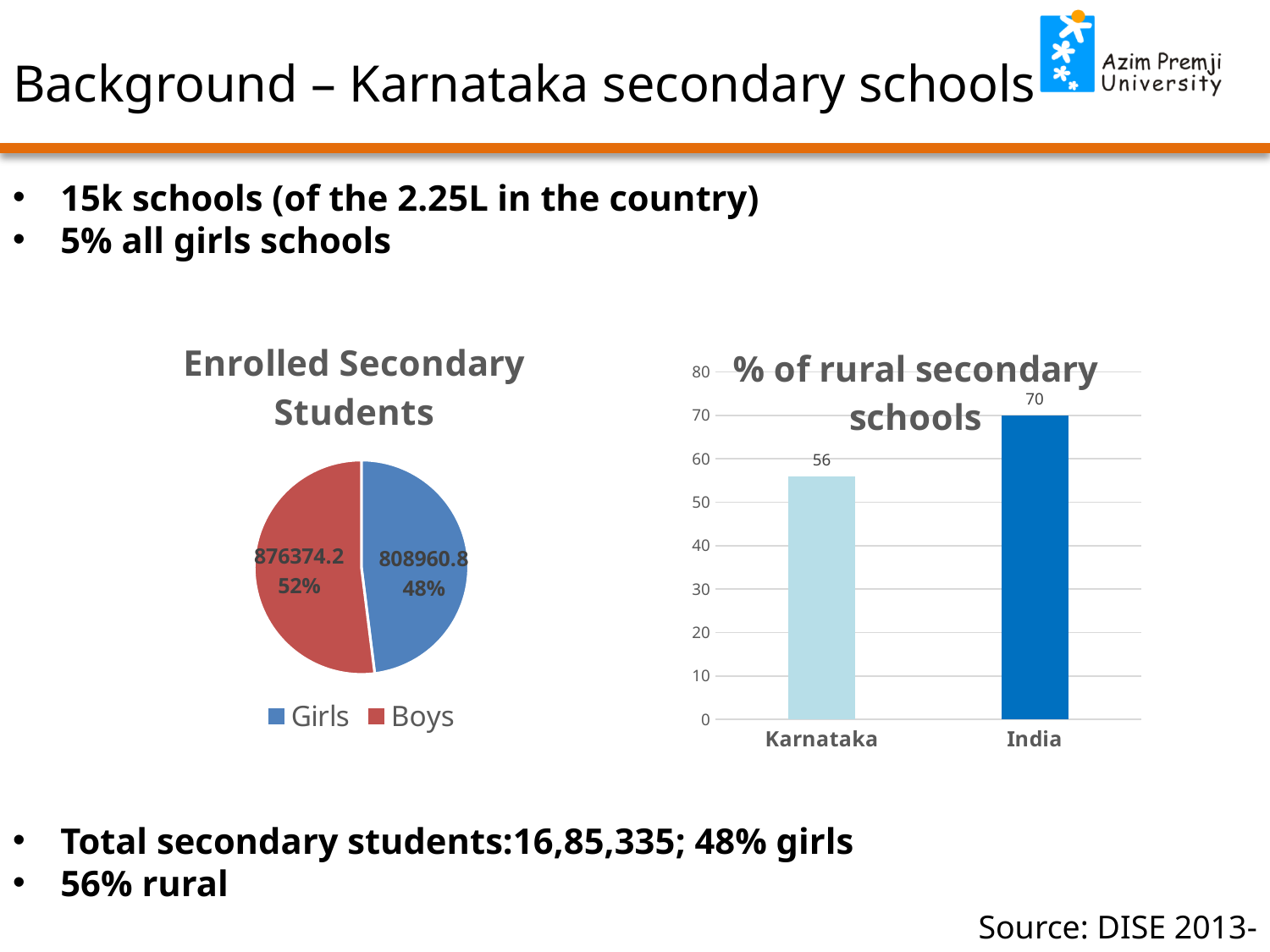
In the '% of rural secondary schools' chart, what is the value for India? 70 In the '% of rural secondary schools' chart, what is the value for Karnataka? 56 In the '% of rural secondary schools' chart, what is the difference between the values for India and Karnataka? 14 What kind of chart is the '% of rural secondary schools' chart? Bar chart What kind of chart is the 'Enrolled Secondary Students' chart? Pie chart In the 'Enrolled Secondary Students' pie chart, which slice is larger, Girls or Boys? Boys How many entries does the legend of the 'Enrolled Secondary Students' pie chart list? 2 In the 'Enrolled Secondary Students' pie chart, what value is shown for Boys? 876374.2 In the 'Enrolled Secondary Students' pie chart, what share of the pie do Boys make up? 52% In the '% of rural secondary schools' chart, which category has the highest value? India In the 'Enrolled Secondary Students' pie chart, what share of the pie do Girls make up? 48% In the 'Enrolled Secondary Students' pie chart, what value is shown for Girls? 808960.8